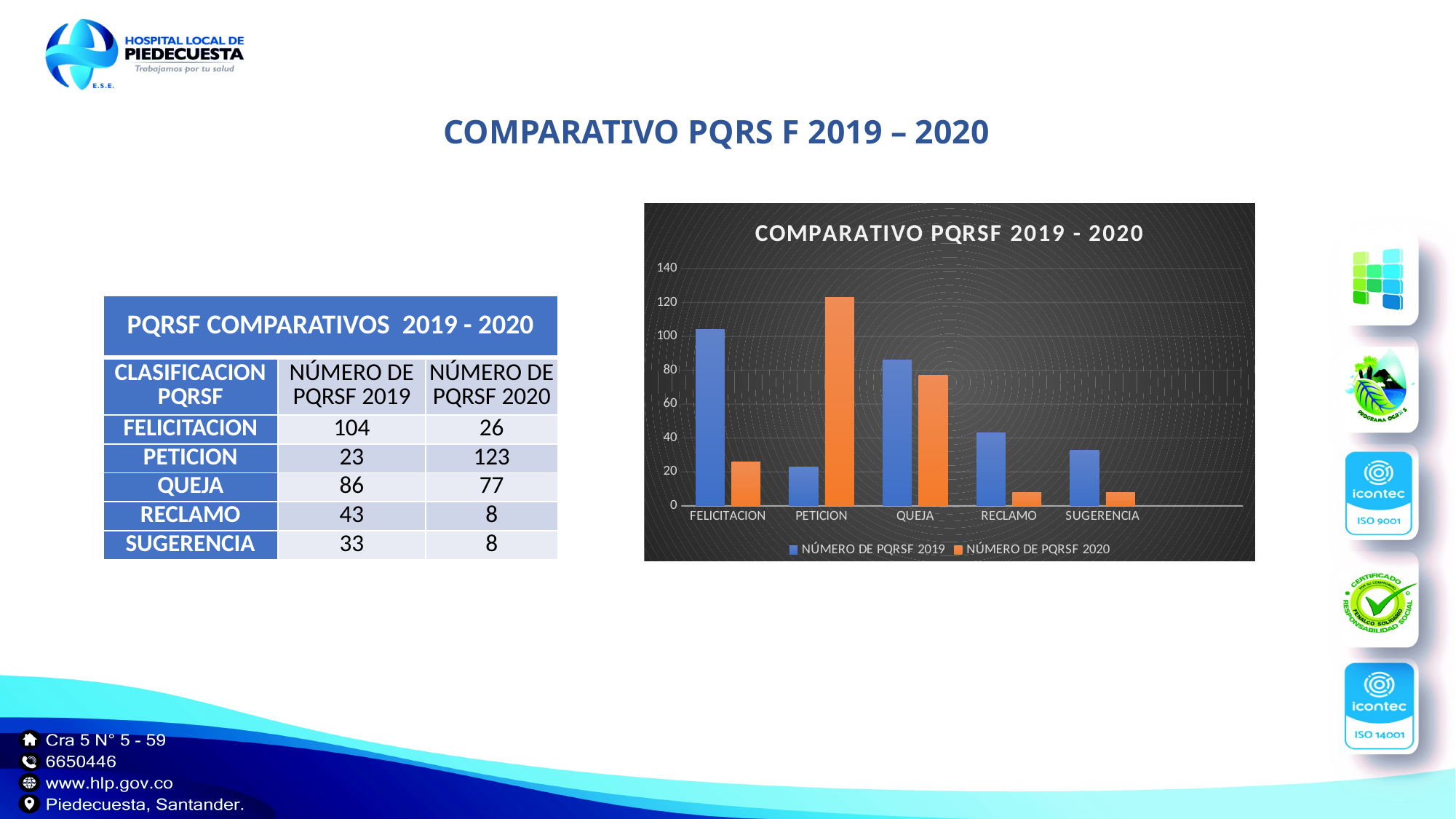
What is the value for PETICION in the NÚMERO DE PQRSF 2020 series? 123 Which category has the lowest value for NÚMERO DE PQRSF 2019? PETICION What is the difference between the NÚMERO DE PQRSF 2019 and NÚMERO DE PQRSF 2020 values for FELICITACION? 78 Is the value for QUEJA in the NÚMERO DE PQRSF 2019 series greater or less than 80? greater What is the title of the chart? COMPARATIVO PQRSF 2019 - 2020 Which category has the highest value for NÚMERO DE PQRSF 2020? PETICION What is the value for FELICITACION in the NÚMERO DE PQRSF 2019 series? 104 How many series does the chart legend list? 2 Which is larger for RECLAMO: NÚMERO DE PQRSF 2019 or NÚMERO DE PQRSF 2020? NÚMERO DE PQRSF 2019 What kind of chart is shown on the slide? bar chart Which category has the highest value for NÚMERO DE PQRSF 2019? FELICITACION How many categories are shown on the x axis of the chart? 5